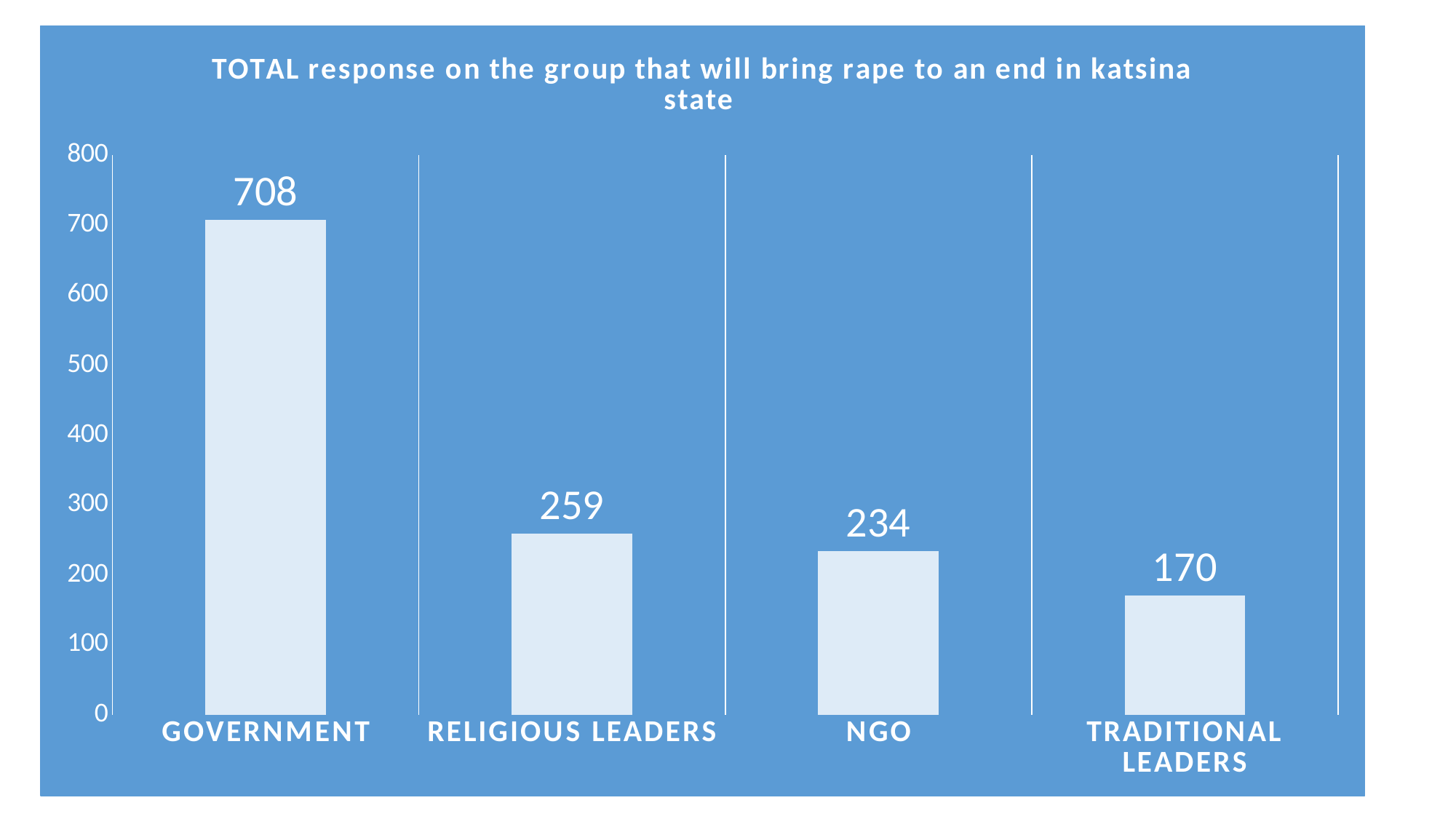
What is the difference between the values for GOVERNMENT and RELIGIOUS LEADERS? 449 Which is larger, the value for RELIGIOUS LEADERS or the value for NGO? RELIGIOUS LEADERS What is the difference between the values for NGO and TRADITIONAL LEADERS? 64 What kind of chart is shown on the slide? Bar chart Which category has the lowest value? TRADITIONAL LEADERS Which category has the highest value? GOVERNMENT What is the value for TRADITIONAL LEADERS? 170 What is the value for NGO? 234 How many categories are shown on the chart? 4 What is the value for GOVERNMENT? 708 What is the value for RELIGIOUS LEADERS? 259 Do the values rise or fall from left to right across the categories? Fall